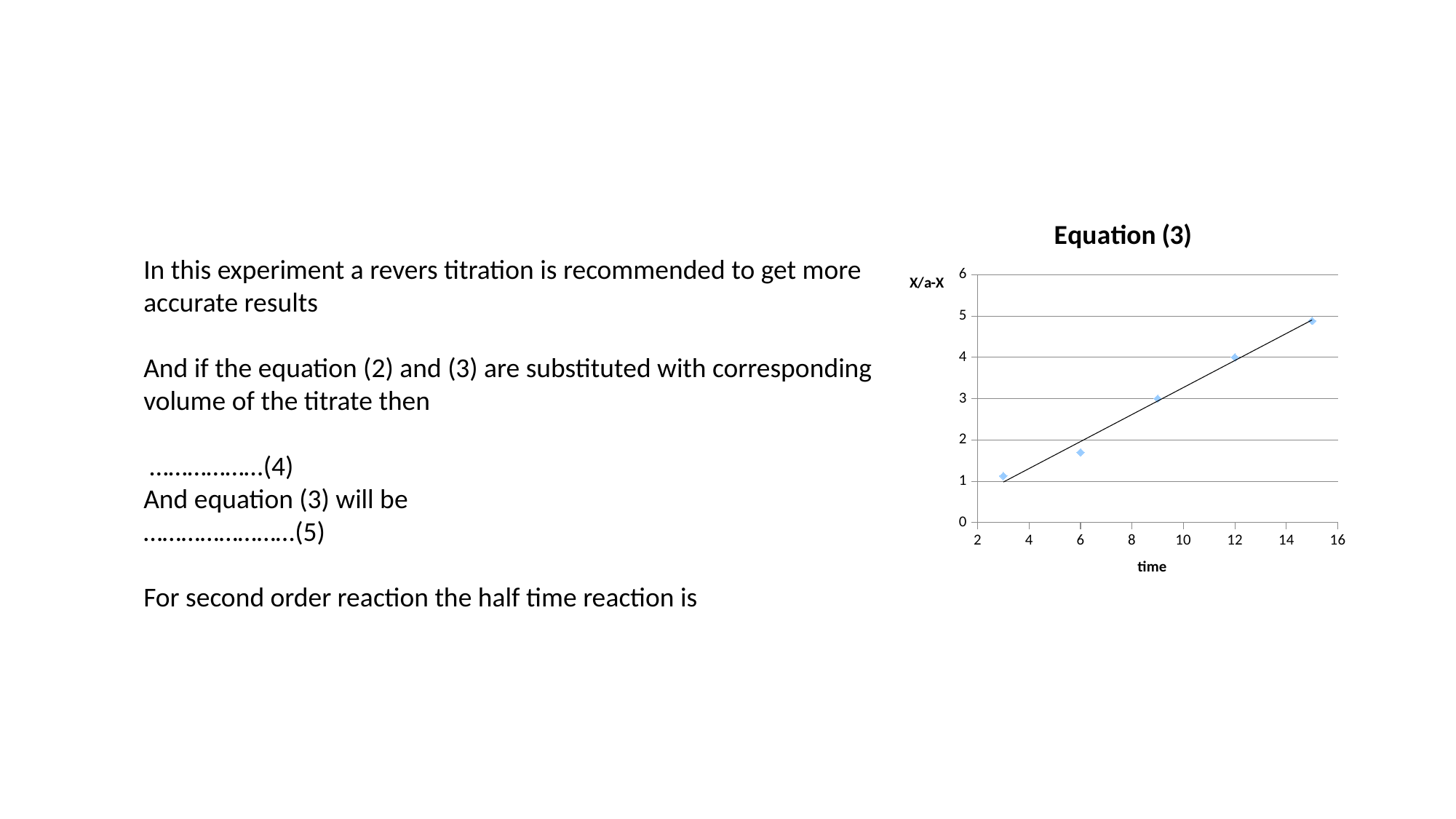
Is the value at time 15 greater or less than 4? greater Is the value at time 3 greater or less than 2? less At which time value is the lowest plotted point? 3 Which point has the highest value on the chart, the one at time 3 or the one at time 15? time 15 How many data points are plotted on the chart? 5 What is the title of the chart? Equation (3) Is the value at time 12 greater or less than 3? greater What is the label of the x axis of the chart? time What kind of chart is shown on the slide? scatter chart Do the plotted values rise or fall as time increases? rise